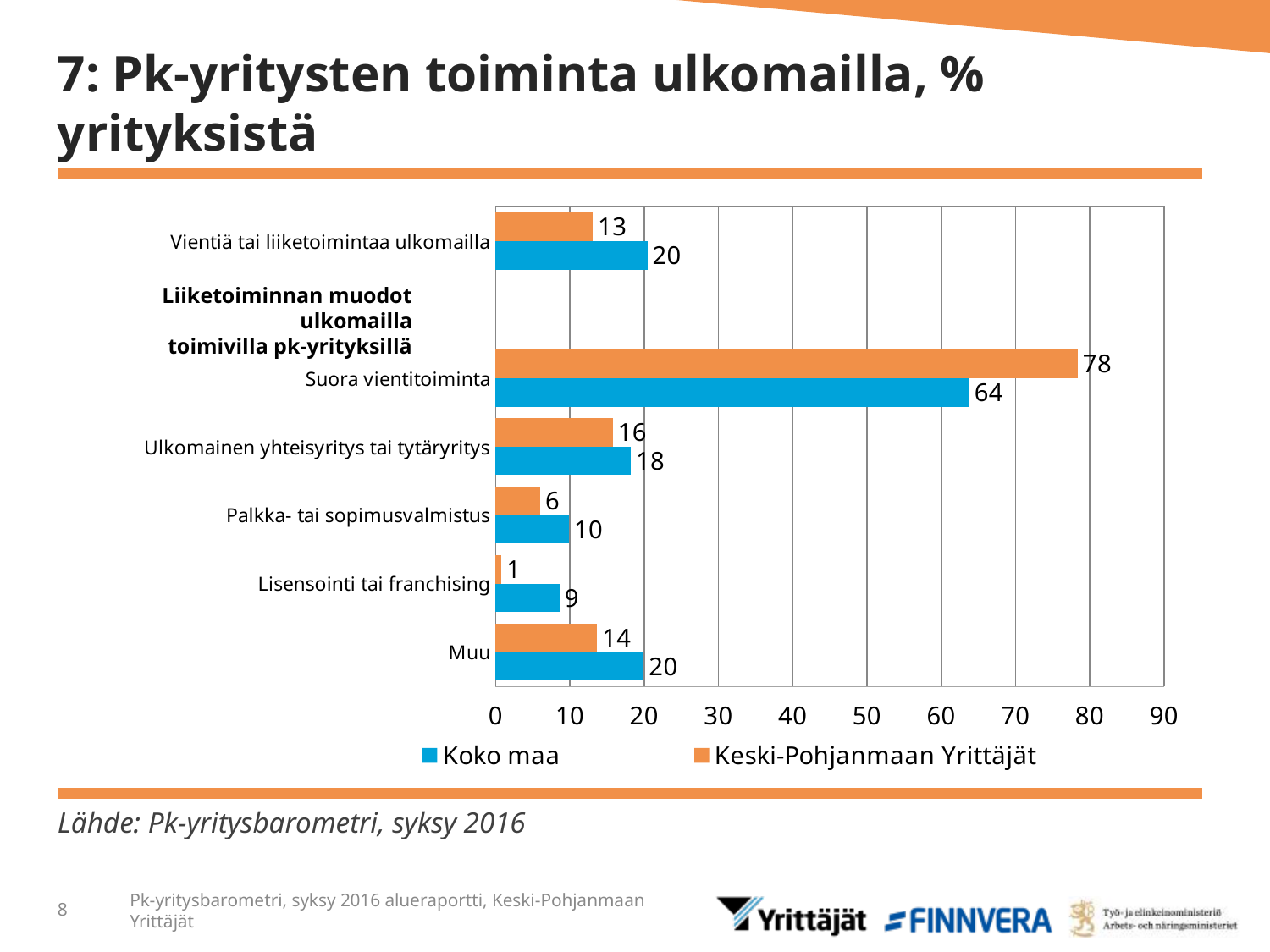
Which series is shown in orange? Keski-Pohjanmaan Yrittäjät What is the value for Keski-Pohjanmaan Yrittäjät for Lisensointi tai franchising? 1 Which category has the lowest value for Keski-Pohjanmaan Yrittäjät? Lisensointi tai franchising For Palkka- tai sopimusvalmistus, which series has the larger value, Koko maa or Keski-Pohjanmaan Yrittäjät? Koko maa What is the value for Koko maa for Vientiä tai liiketoimintaa ulkomailla? 20 What is the value for Koko maa for Suora vientitoiminta? 64 What is the value for Koko maa for Muu? 20 Which category has the highest value for Koko maa? Suora vientitoiminta What kind of chart is shown on the slide? Bar chart What is the value for Keski-Pohjanmaan Yrittäjät for Suora vientitoiminta? 78 How many series does the legend list? 2 What is the difference between the Keski-Pohjanmaan Yrittäjät and Koko maa values for Suora vientitoiminta? 14